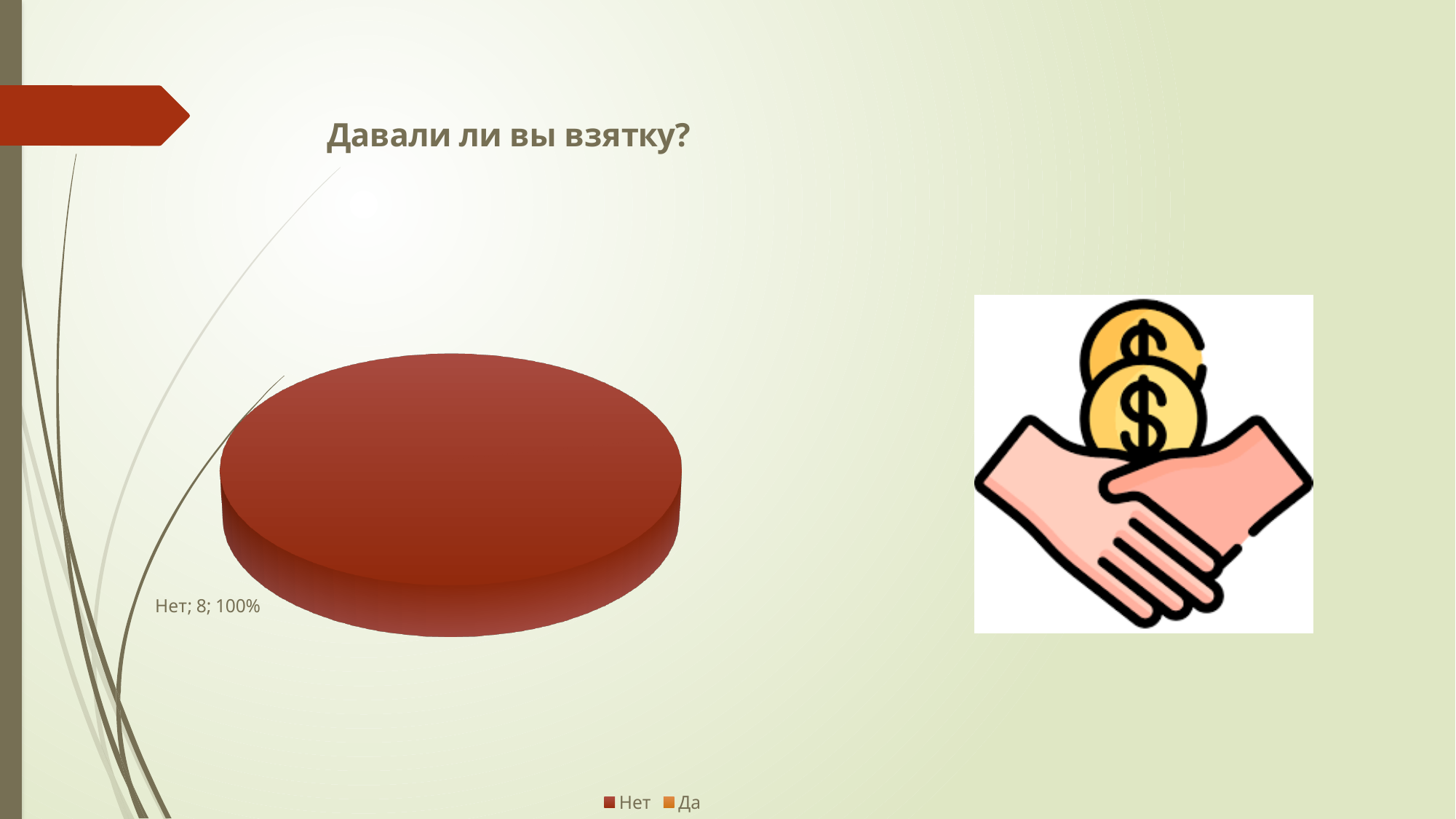
What colour is the "Нет" slice in the pie chart? red Which legend entry has no visible slice in the pie? Да What share of the pie does the "Нет" slice take? 100% What kind of chart is shown on the slide? pie chart How many entries does the chart's legend list? 2 What value is shown for the "Нет" slice? 8 Which category has the largest slice of the pie? Нет Which category is larger, "Нет" or "Да"? Нет What is the title of the chart? Давали ли вы взятку? How many slices are visible in the pie chart? 1